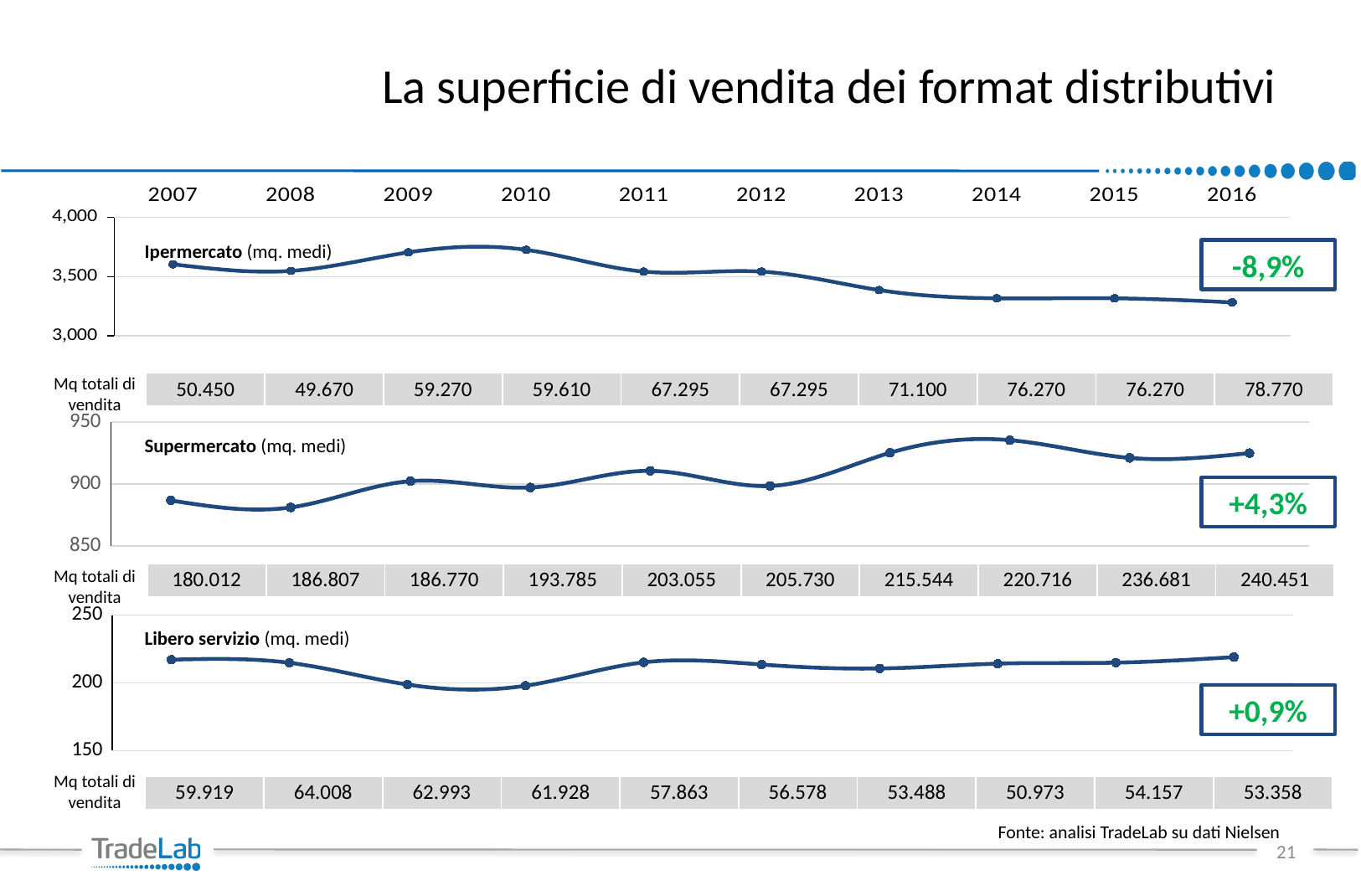
What percentage change is shown in the box on the Ipermercato (mq. medi) chart? -8,9% In the Mq totali di vendita row under the Ipermercato chart, what is the value for 2007? 50.450 On the Ipermercato (mq. medi) chart, is the value for 2016 greater or less than 3,500? less In the Mq totali di vendita row under the Libero servizio chart, which year has the lowest value? 2014 On the Ipermercato (mq. medi) chart, is the value for 2009 greater or less than 3,500? greater On the Supermercato (mq. medi) chart, is the value for 2014 greater or less than 900? greater On the Ipermercato (mq. medi) chart, do the values overall rise or fall from 2007 to 2016? fall On the Supermercato (mq. medi) chart, do the values overall rise or fall from 2007 to 2016? rise In the Mq totali di vendita row under the Supermercato chart, what is the value for 2016? 240.451 How many years are plotted on the Supermercato (mq. medi) chart? 10 What kind of chart is the Ipermercato (mq. medi) chart? line chart